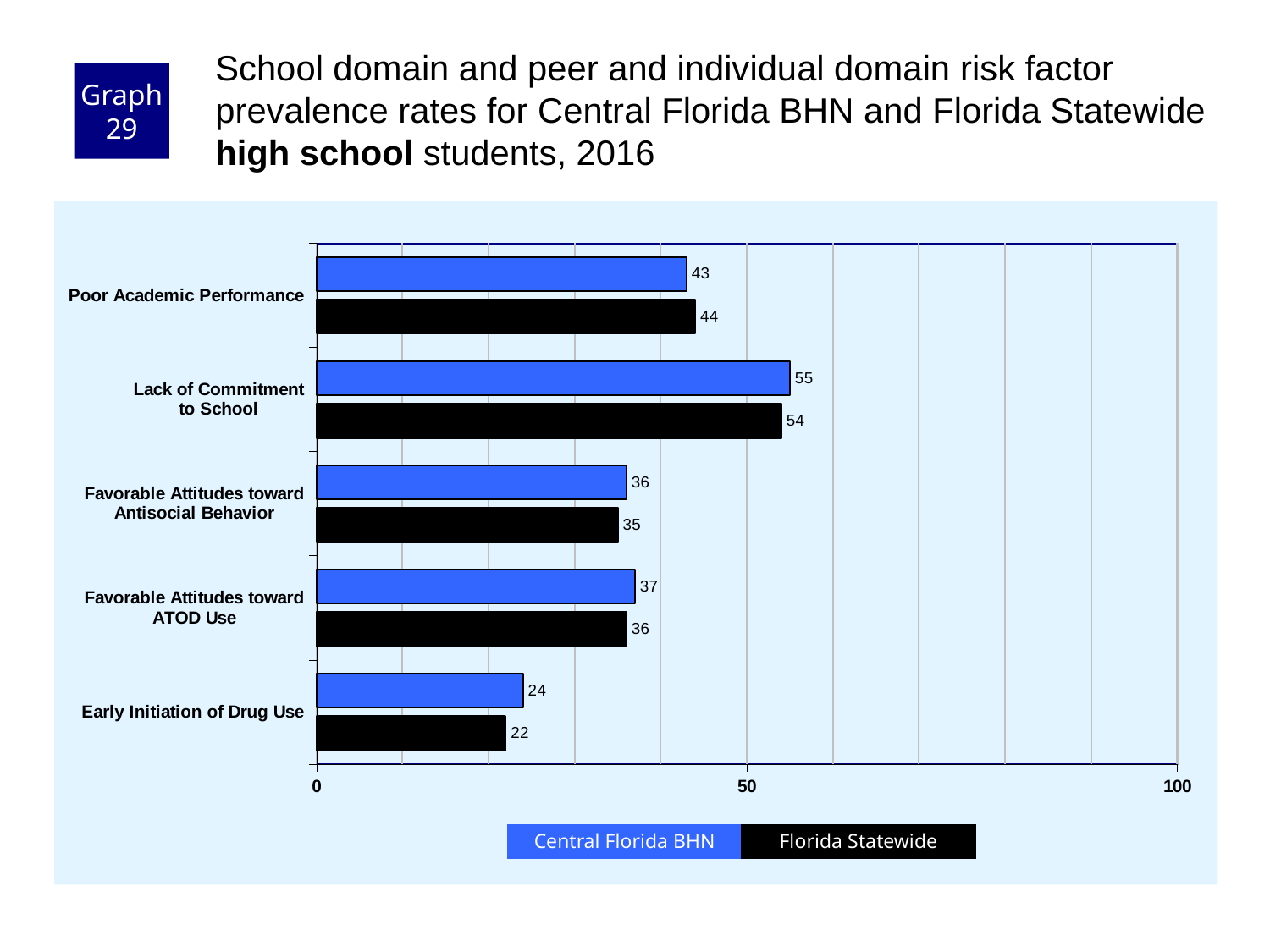
Is the Central Florida BHN value for Lack of Commitment to School greater or less than 50? greater How many series does the legend list? 2 Which colour represents Florida Statewide in the chart? black For Poor Academic Performance, which is larger: the Central Florida BHN value or the Florida Statewide value? Florida Statewide What is the Florida Statewide value for Lack of Commitment to School? 54 What is the Florida Statewide value for Early Initiation of Drug Use? 22 Which risk factor has the lowest Florida Statewide value? Early Initiation of Drug Use What is the Central Florida BHN value for Poor Academic Performance? 43 Which risk factor has the highest Central Florida BHN value? Lack of Commitment to School What kind of chart is shown on the slide? bar chart What is the difference between the Central Florida BHN and Florida Statewide values for Early Initiation of Drug Use? 2 How many risk factor categories are shown on the chart? 5